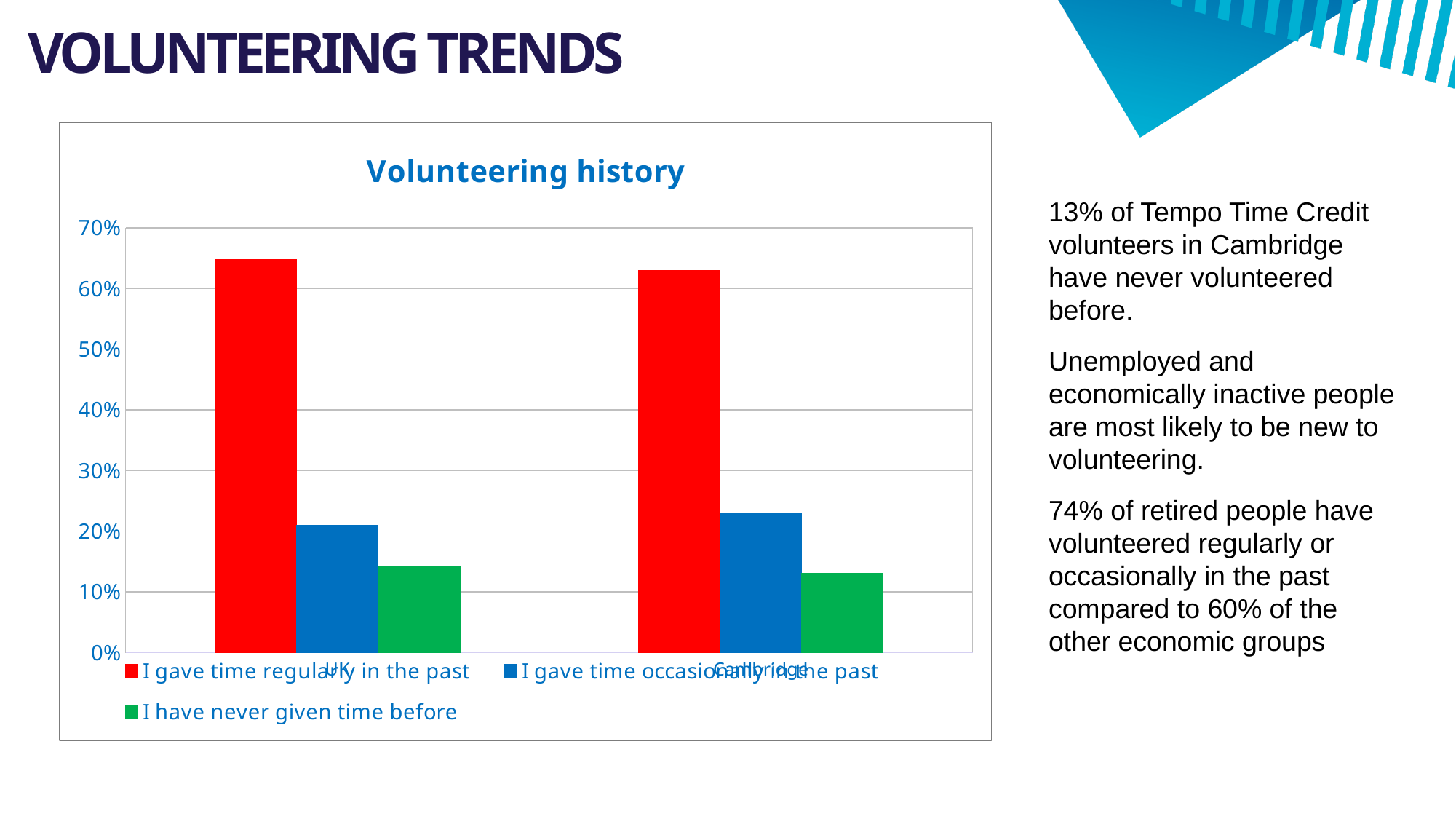
Is the value for 'I gave time occasionally in the past' for Cambridge greater or less than 30%? less What colour represents 'I have never given time before' in the chart? Green How many series does the chart legend list? 3 Is the value for 'I gave time regularly in the past' for UK greater or less than 60%? greater Is the value for 'I gave time regularly in the past' for Cambridge greater or less than 60%? greater What type of chart is shown on the slide? Bar chart Which series has the lowest value for Cambridge? I have never given time before What is the title of the chart? Volunteering history For UK, which is larger: 'I gave time occasionally in the past' or 'I have never given time before'? I gave time occasionally in the past How many categories are shown on the x axis of the chart? 2 Which series has the highest value for UK? I gave time regularly in the past